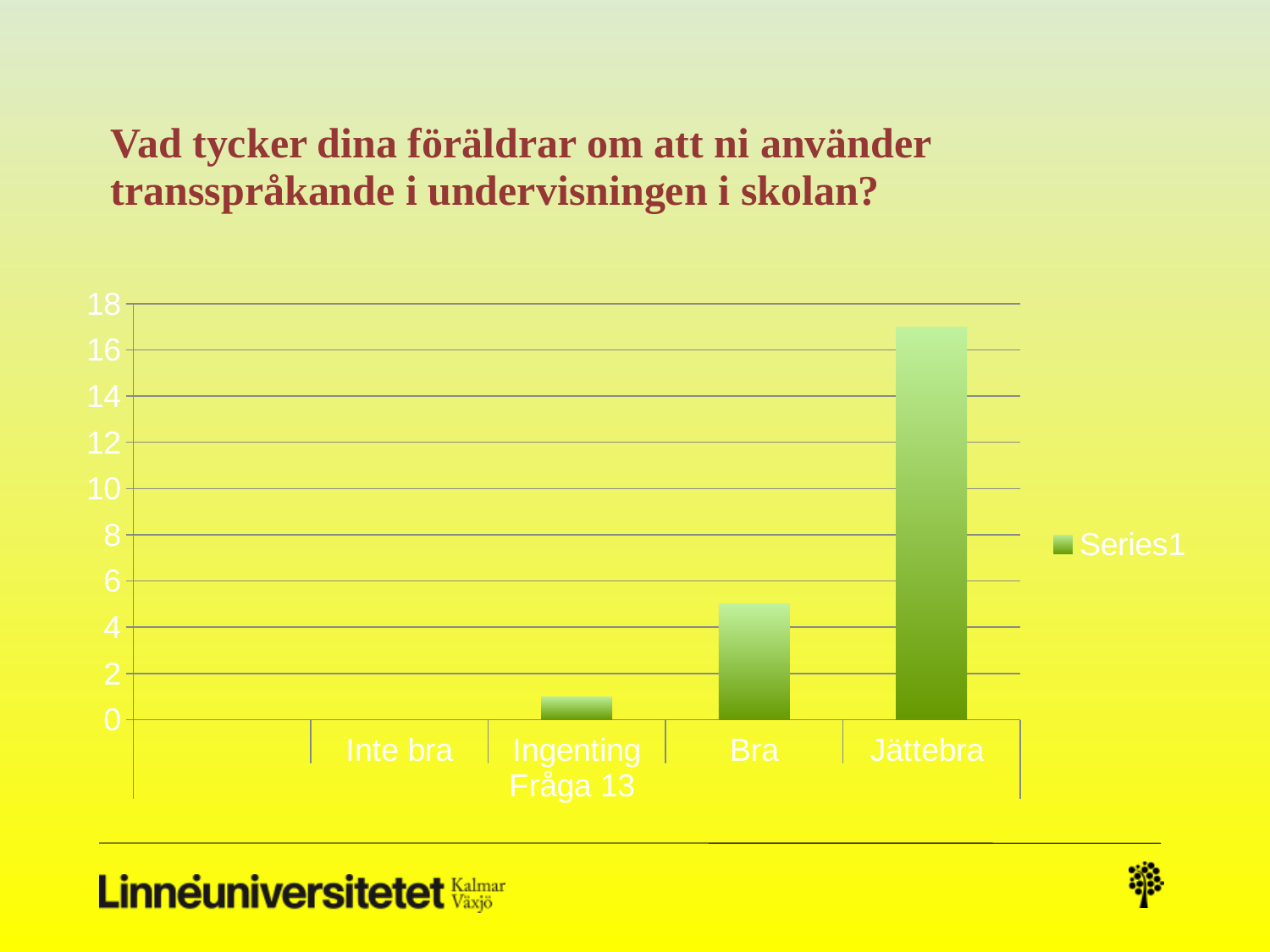
How many categories are shown on the x axis of the chart? 4 Is the value for Bra greater or less than 4? greater What is the name of the series listed in the chart's legend? Series1 Is the value for Ingenting greater or less than 2? less Which is larger, the value for Ingenting or the value for Bra? Bra Which category has the lowest value in the chart? Inte bra What kind of chart is shown on the slide? bar chart Which category has the highest value in the chart? Jättebra How many series does the chart's legend list? 1 Do the values rise or fall moving from left to right along the x axis? rise Which is larger, the value for Bra or the value for Jättebra? Jättebra Is the value for Jättebra greater or less than 16? greater